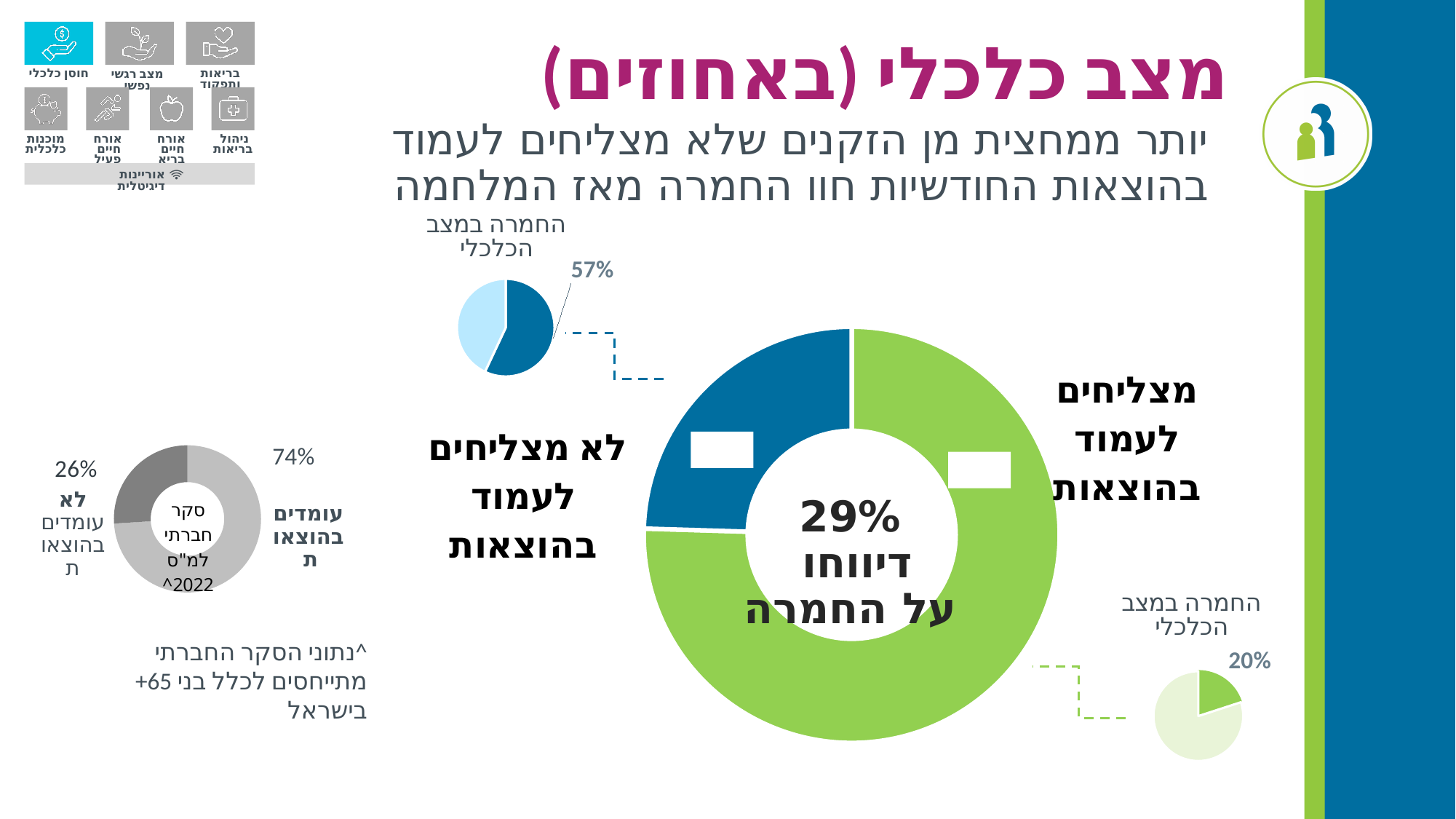
What kind of chart is the large chart in the centre of the slide? Donut (pie) chart Which small pie chart shows a higher share for החמרה במצב הכלכלי: the one next to לא מצליחים לעמוד בהוצאות or the one next to מצליחים לעמוד בהוצאות? The one next to לא מצליחים לעמוד בהוצאות In the small pie chart at the top left of the large donut (next to לא מצליחים לעמוד בהוצאות), what percentage is labelled for החמרה במצב הכלכלי? 57% In the large donut chart in the centre of the slide, which slice is larger: מצליחים לעמוד בהוצאות or לא מצליחים לעמוד בהוצאות? מצליחים לעמוד בהוצאות In the small donut chart on the left of the slide (סקר חברתי למ"ס 2022), what percentage is shown for עומדים בהוצאות? 74% How many categories does the small donut chart on the left of the slide (סקר חברתי למ"ס 2022) show? 2 What is the difference in percentage points between the החמרה במצב הכלכלי shares in the two small pie charts (57% and 20%)? 37 percentage points In the small pie chart at the bottom right of the large donut (next to מצליחים לעמוד בהוצאות), what percentage is labelled for החמרה במצב הכלכלי? 20% In the small donut chart on the left of the slide (סקר חברתי למ"ס 2022), what is the difference in percentage points between עומדים בהוצאות and לא עומדים בהוצאות? 48 percentage points What percentage is printed in the centre of the large donut chart? 29% In the small donut chart on the left of the slide (סקר חברתי למ"ס 2022), what percentage is shown for לא עומדים בהוצאות? 26% In the small donut chart on the left of the slide (סקר חברתי למ"ס 2022), which category is larger: עומדים בהוצאות or לא עומדים בהוצאות? עומדים בהוצאות